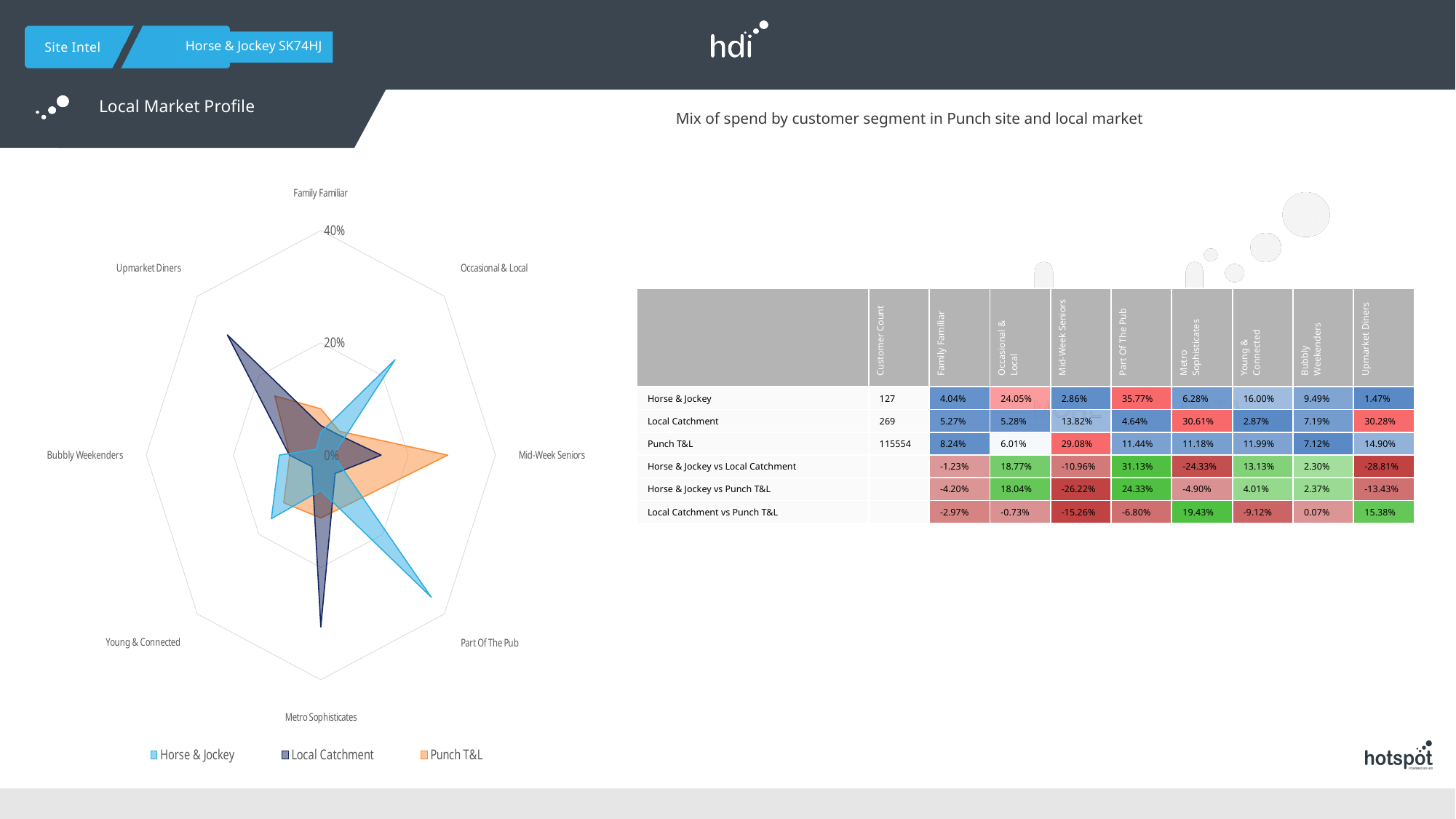
Which customer segment has the lowest value for Horse & Jockey? Upmarket Diners What is the difference between Horse & Jockey and Local Catchment for Part Of The Pub? 31.13% For Mid-Week Seniors, which is larger: Punch T&L or Horse & Jockey? Punch T&L Which customer segment has the highest value for Horse & Jockey? Part Of The Pub Is the Horse & Jockey value for Occasional & Local greater or less than 20%? greater How many series does the legend of the radar chart list? 3 What is the Horse & Jockey value for Part Of The Pub? 35.77% How many customer segments (axes) does the radar chart have? 8 What is the Punch T&L value for Mid-Week Seniors? 29.08% Which customer segment has the highest value for Punch T&L? Mid-Week Seniors What type of chart is shown on the left of the slide? Radar chart What is the Local Catchment value for Upmarket Diners? 30.28%